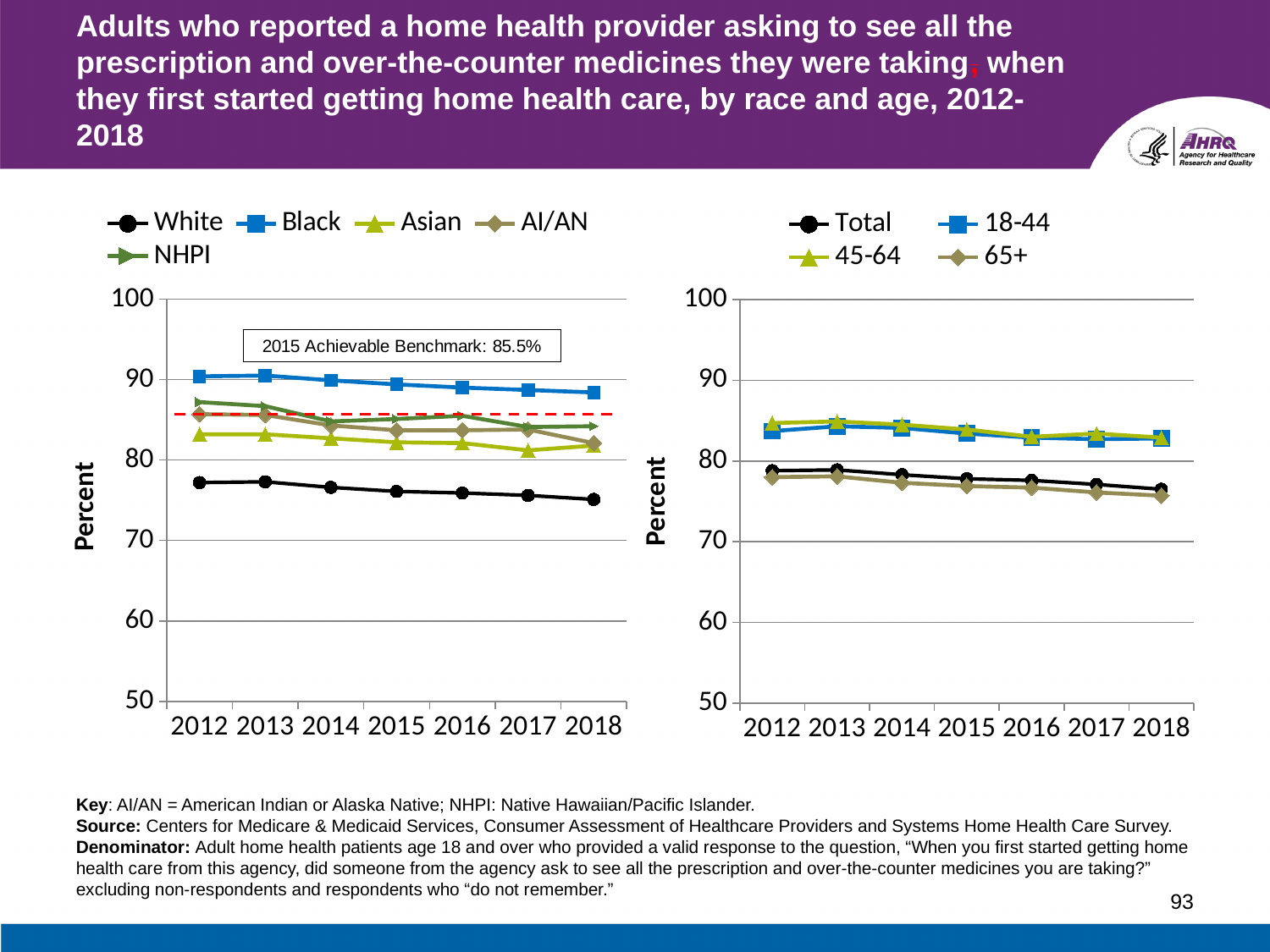
What is the 2015 Achievable Benchmark shown on the left chart (by race)? 85.5% In the right chart (by age), is the value for 45-64 in 2012 greater or less than 80? greater How many series does the legend of the left chart (by race) list? 5 What kind of chart is the left chart (by race)? line chart In the left chart (by race), is the value for White in 2018 greater or less than 80? less How many series does the legend of the right chart (by age) list? 4 In the left chart (by race), which group has the lowest values across all years? White In the left chart (by race), which group has the highest values across all years? Black In the right chart (by age), is the value for 65+ in 2018 greater or less than 80? less How many years are plotted along the x axis of the right chart (by age)? 7 In the left chart (by race), do the values for Black rise or fall from 2012 to 2018? fall